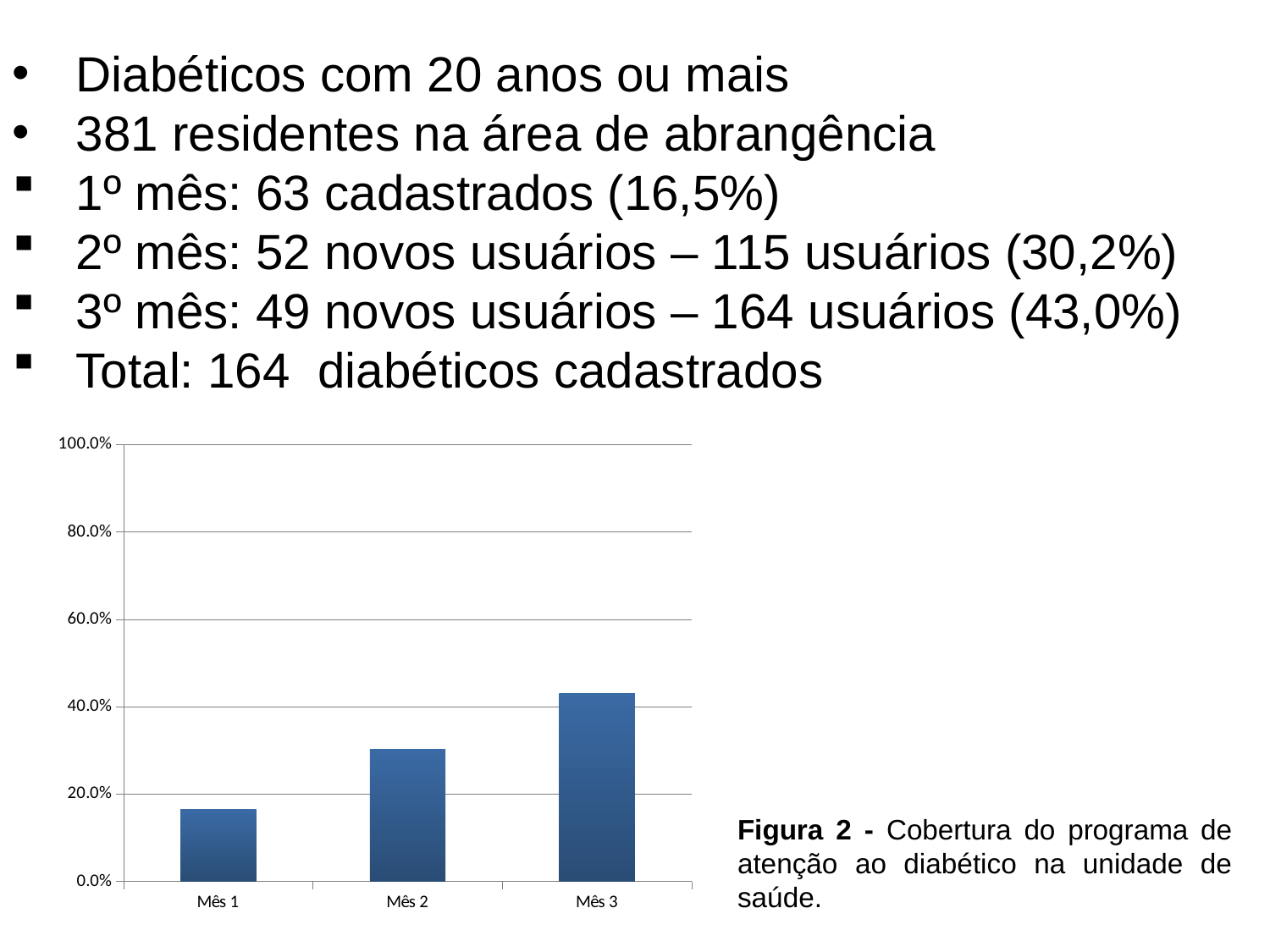
What kind of chart is shown on the slide? bar chart Which month has the lowest bar in the chart? Mês 1 Is the value for Mês 3 greater or less than 40.0%? greater What is the maximum value shown on the chart's vertical axis? 100.0% Is the value for Mês 2 greater or less than 20.0%? greater Is the value for Mês 2 greater or less than 40.0%? less Do the values rise or fall from Mês 1 to Mês 3? rise What is the figure number given in the caption next to the chart? Figura 2 Which month has the highest bar in the chart? Mês 3 Which is larger, the value for Mês 2 or the value for Mês 3? Mês 3 How many categories (months) are plotted on the chart? 3